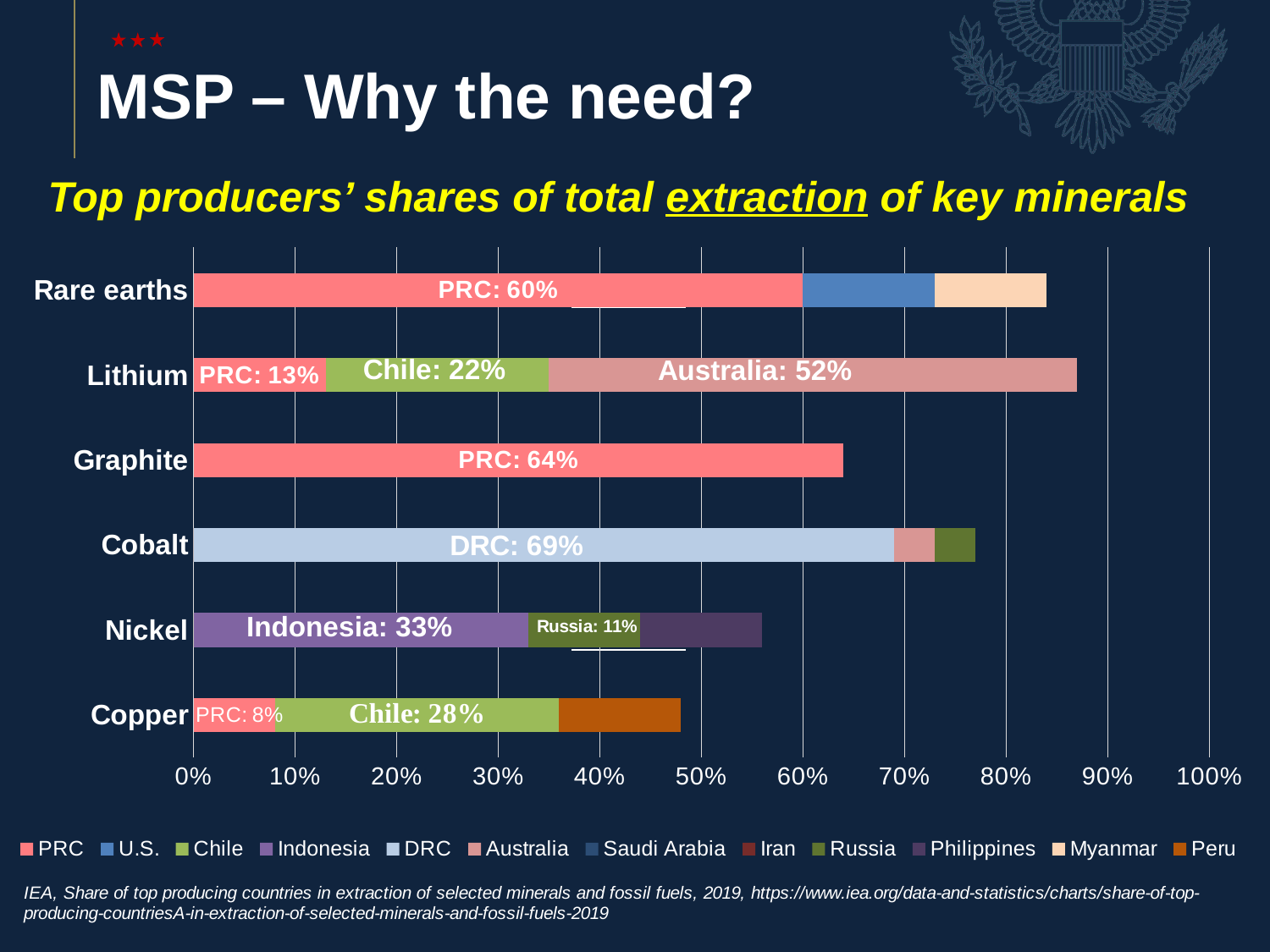
What share of rare earths extraction does the PRC account for? 60% What is the difference between Chile's share of copper extraction and Chile's share of lithium extraction? 6 percentage points Is the total stacked bar for Lithium greater or less than 80%? greater How many minerals are shown on the chart? 6 What is Australia's share of lithium extraction? 52% What kind of chart is shown on the slide? Stacked bar chart What is the title of the chart? Top producers' shares of total extraction of key minerals What is the DRC's share of cobalt extraction? 69% What is Russia's share of nickel extraction? 11% How many countries does the legend list? 12 Is the PRC's share larger for graphite or for rare earths? Graphite Which mineral has the shortest total stacked bar? Copper